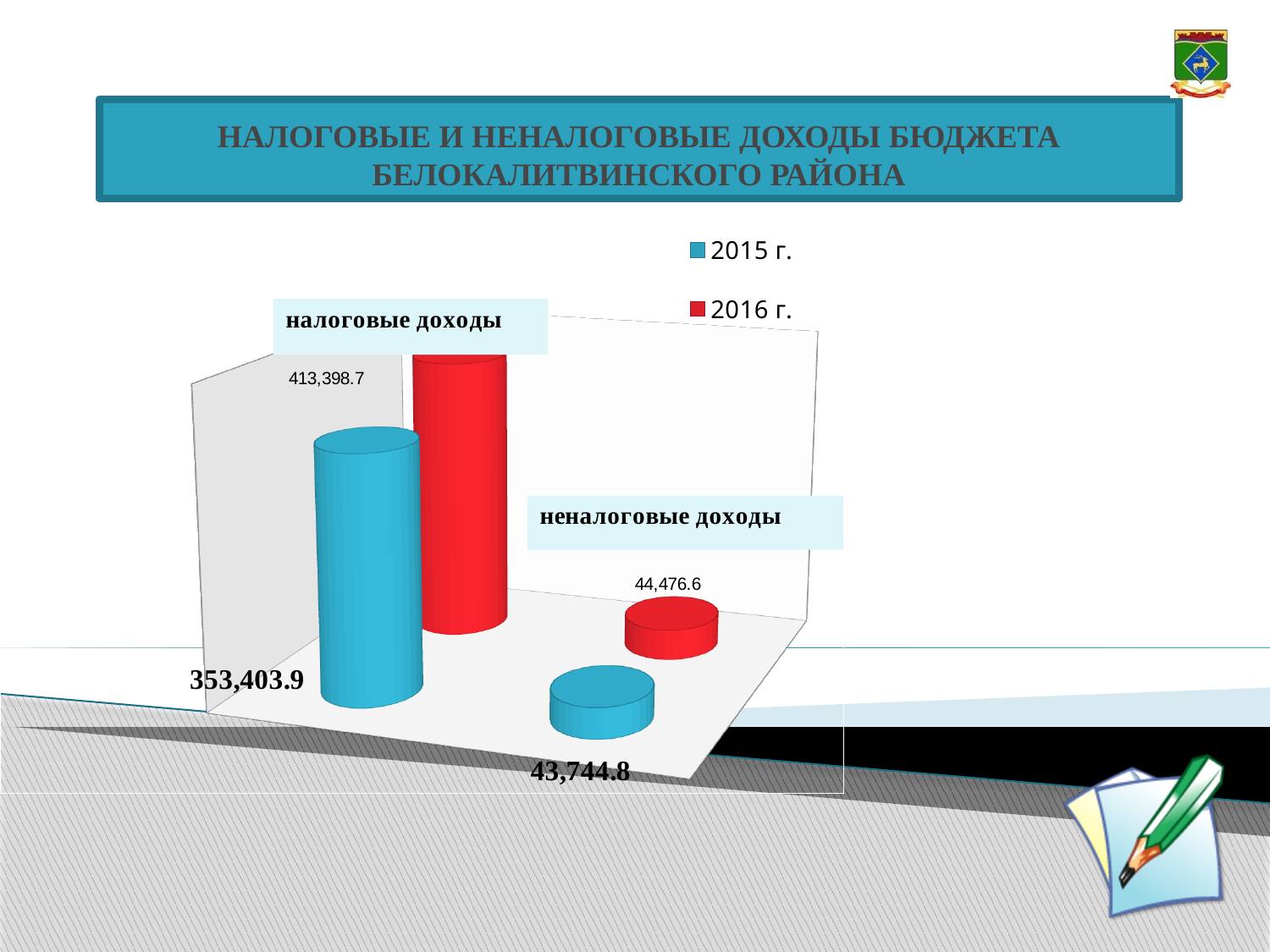
What is the value for неналоговые доходы in 2016 г.? 44,476.6 What is the value for налоговые доходы in 2016 г.? 413,398.7 Which category has the lowest value in 2015 г.? неналоговые доходы How many series does the legend list? 2 What kind of chart is shown on the slide? bar chart What is the difference between the 2016 г. and 2015 г. values for налоговые доходы? 59,994.8 What is the difference between the 2016 г. and 2015 г. values for неналоговые доходы? 731.8 Which is larger for налоговые доходы: the 2015 г. value or the 2016 г. value? 2016 г. What is the value for налоговые доходы in 2015 г.? 353,403.9 What is the value for неналоговые доходы in 2015 г.? 43,744.8 How many categories are shown on the chart? 2 Which category has the highest value in 2016 г.? налоговые доходы